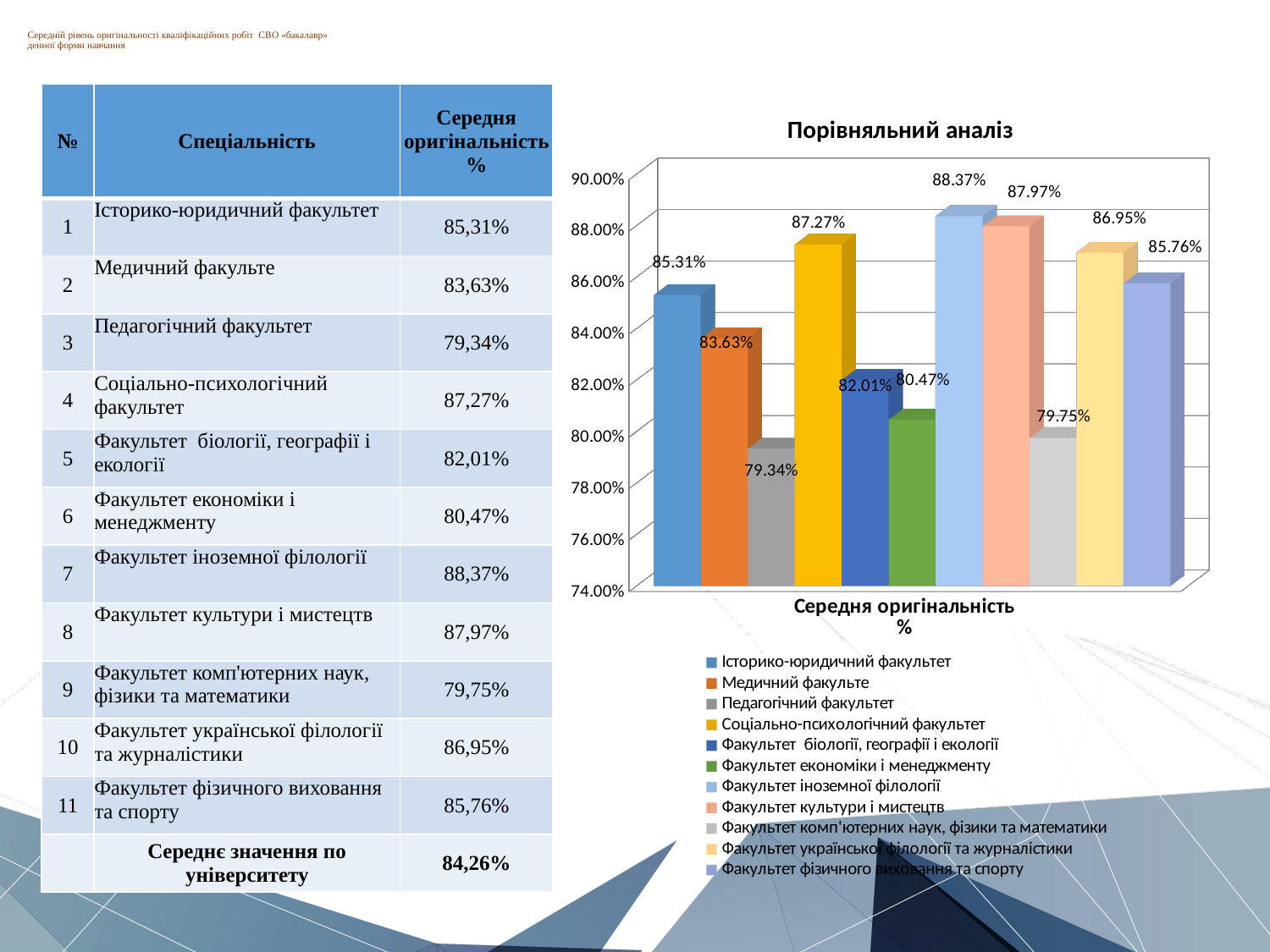
Is the value for Факультет культури і мистецтв greater or less than 86.00%? greater What is the value shown for Педагогічний факультет? 79.34% What is the title of the chart? Порівняльний аналіз How many bars are plotted in the chart? 11 What is the difference between the values for Факультет іноземної філології and Педагогічний факультет? 9.03% Which is larger: the value for Медичний факульте or the value for Факультет біології, географії і екології? Медичний факульте What is the value shown for Факультет економіки і менеджменту? 80.47% Which faculty has the highest value in the chart? Факультет іноземної філології What type of chart is shown on the slide? bar chart Which faculty has the lowest value in the chart? Педагогічний факультет What is the value shown for Факультет іноземної філології? 88.37% How many series does the chart legend list? 11